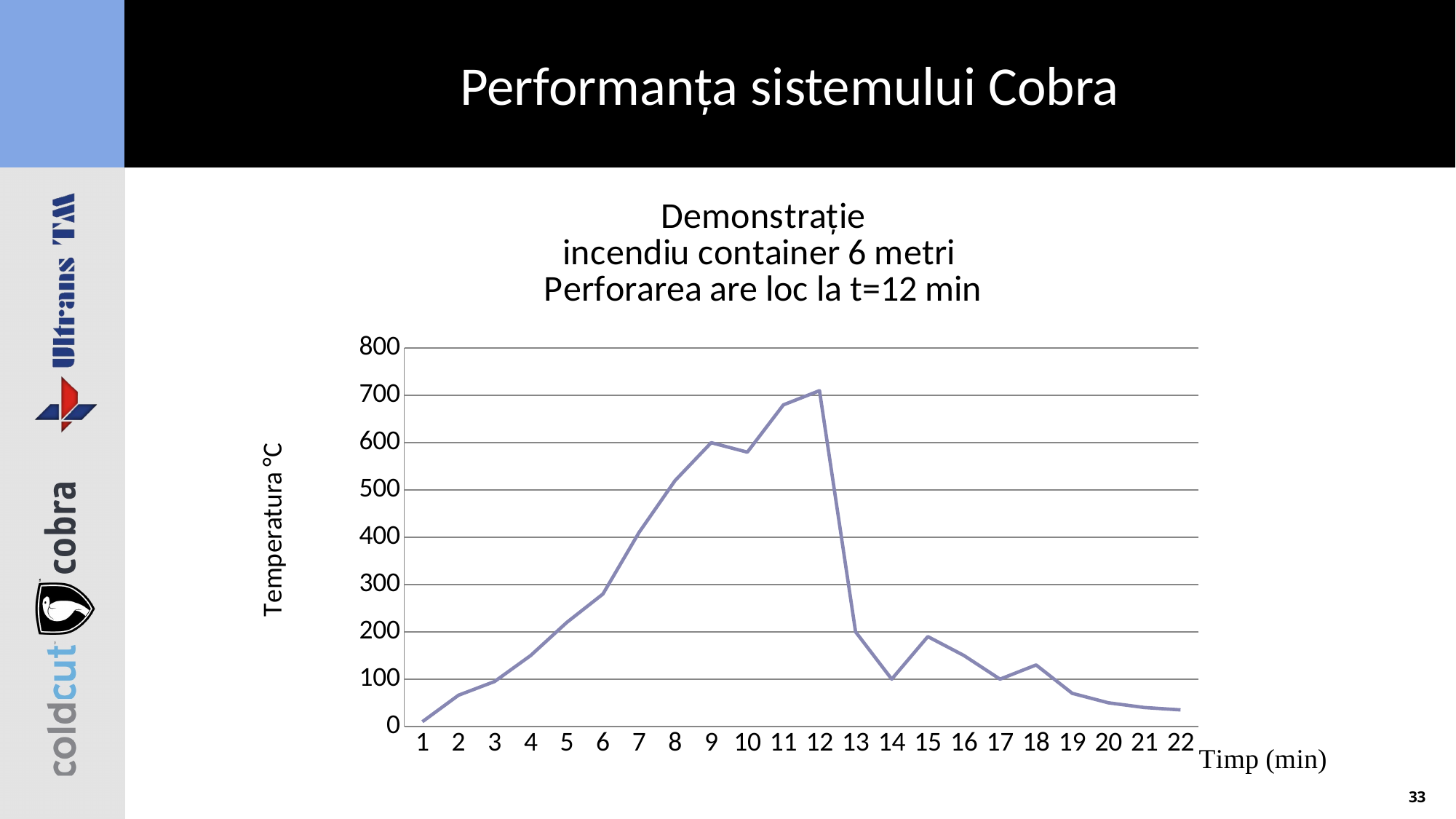
Which has the higher temperature, t=11 min or t=13 min? t=11 min According to the chart title, at what time does the perforation take place? t=12 min Is the temperature at t=22 min greater or less than 100? less At which time (in minutes) does the temperature reach its highest value? 12 What is the label of the y axis? Temperatura °C Does the temperature rise or fall between t=1 min and t=12 min? rise What kind of chart is shown on the slide? line chart Is the temperature at t=13 min greater or less than 300? less At which time (in minutes) is the temperature lowest? 1 How many time points are plotted on the x axis? 22 Is the temperature at t=12 min greater or less than 600? greater